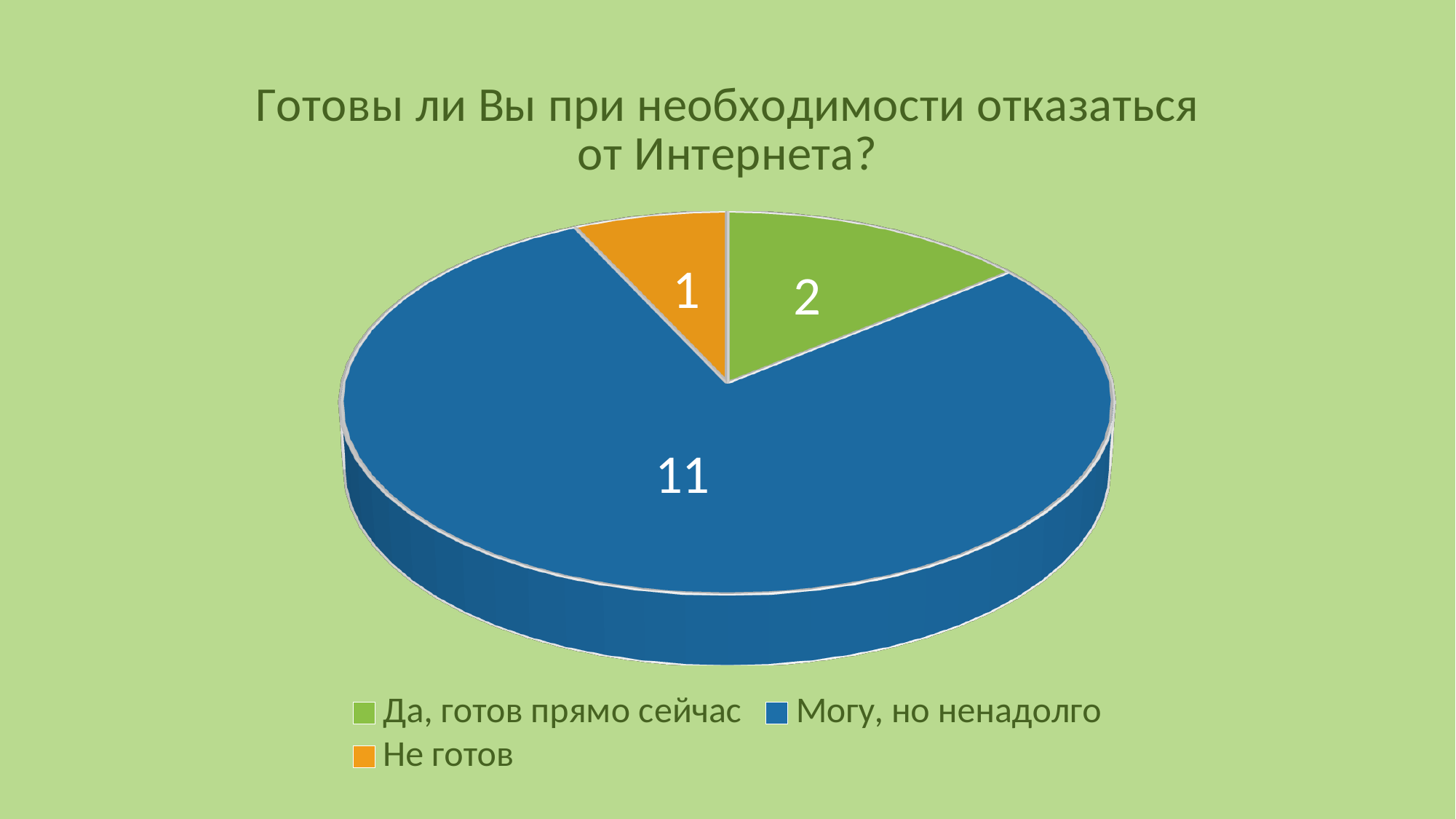
What type of chart is shown on the slide? Pie chart Which category has the largest slice? Могу, но ненадолго What is the value for "Да, готов прямо сейчас"? 2 Which category has the smallest slice? Не готов What is the total of all slices in the pie chart? 14 How many slices does the pie chart have? 3 What is the difference between the values for "Могу, но ненадолго" and "Да, готов прямо сейчас"? 9 What colour is the slice for "Не готов"? Orange What is the value for "Могу, но ненадолго"? 11 What is the value for "Не готов"? 1 What is the title of the chart? Готовы ли Вы при необходимости отказаться от Интернета? Which is larger: the value for "Да, готов прямо сейчас" or the value for "Не готов"? Да, готов прямо сейчас